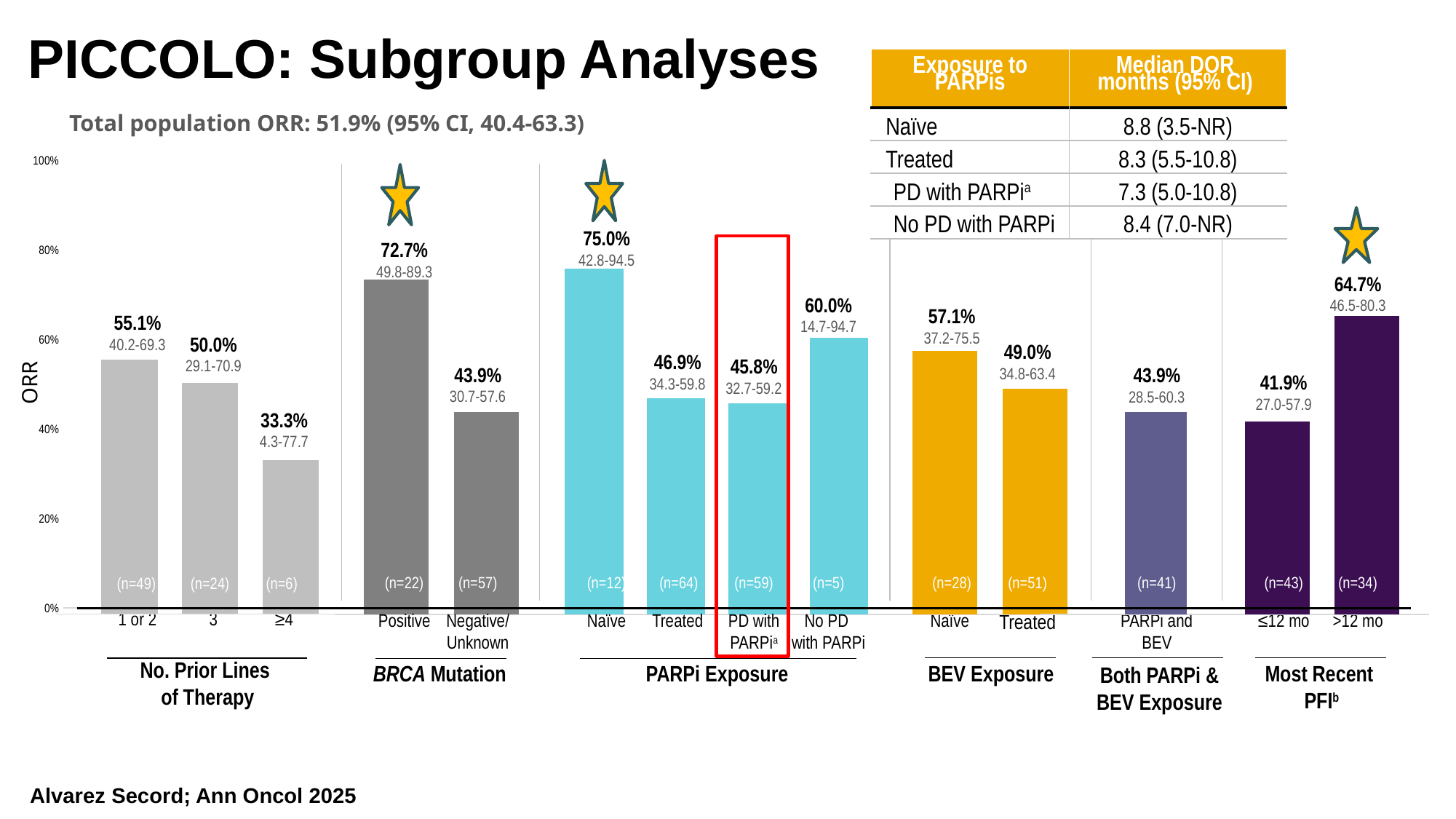
What is the difference in ORR between BRCA Mutation Positive and Negative/Unknown? 28.8 percentage points What is the ORR for patients with PD with PARPi in the PARPi Exposure group? 45.8% Which has a higher ORR: BEV Exposure Naïve or BEV Exposure Treated? BEV Exposure Naïve Is the ORR for the PD with PARPi subgroup greater or less than 40%? greater How many subgroup bars are plotted on the chart? 14 What is the total population ORR stated above the chart? 51.9% Which subgroup has the lowest ORR on the chart? ≥4 prior lines of therapy (33.3%) What kind of chart is shown on the slide? Bar chart Which subgroup has the highest ORR on the chart? PARPi Exposure Naïve (75.0%) What is the ORR for the >12 mo Most Recent PFI subgroup? 64.7% What is the ORR for the BRCA Mutation Positive subgroup? 72.7% What is the difference in ORR between the >12 mo and ≤12 mo Most Recent PFI subgroups? 22.8 percentage points